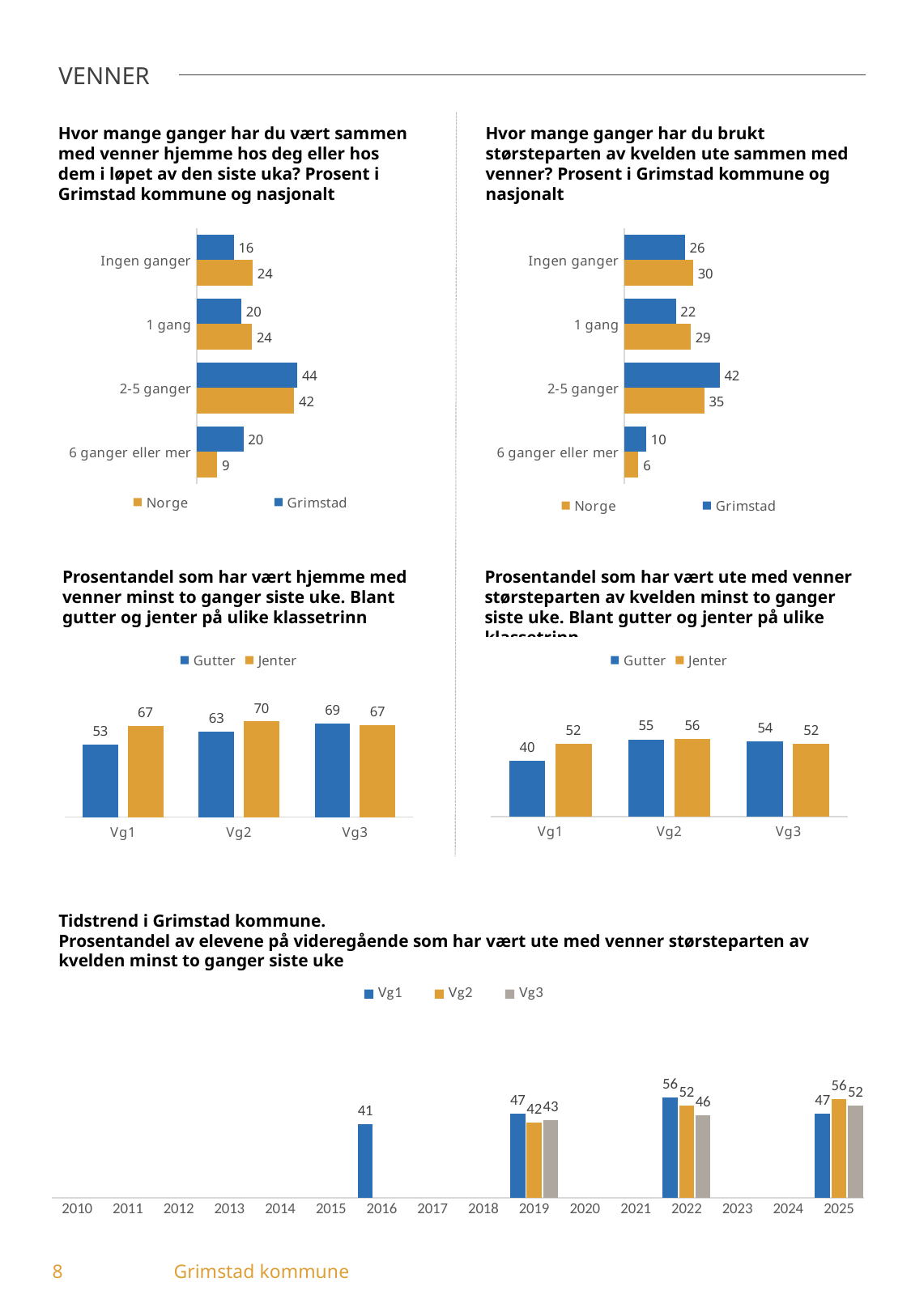
In the top-left chart (friends at home in the last week), what is the difference between Grimstad and Norge for '6 ganger eller mer'? 11 How many series does the legend list in the top-left chart (friends at home in the last week)? 2 In the middle-left chart (home with friends at least twice, by gender and grade), what is the difference between Jenter and Gutter at Vg1? 14 In the bottom chart (Tidstrend i Grimstad kommune), which series has the highest value in 2025? Vg2 In the middle-left chart (home with friends at least twice, by gender and grade), what is the value for Jenter at Vg2? 70 In the top-right chart (evenings out with friends), what is the value for Norge for '1 gang'? 29 What kind of chart is the bottom chart (Tidstrend i Grimstad kommune)? Bar chart In the top-right chart (evenings out with friends), which category has the lowest value for Norge? 6 ganger eller mer In the bottom chart (Tidstrend i Grimstad kommune), what is the value for Vg3 in 2022? 46 In the top-right chart (evenings out with friends), which is larger for 'Ingen ganger': Norge or Grimstad? Norge In the middle-right chart (out with friends at least twice, by gender and grade), which grade has the lowest value for Gutter? Vg1 In the top-left chart (friends at home in the last week), what is the value for Grimstad for '2-5 ganger'? 44